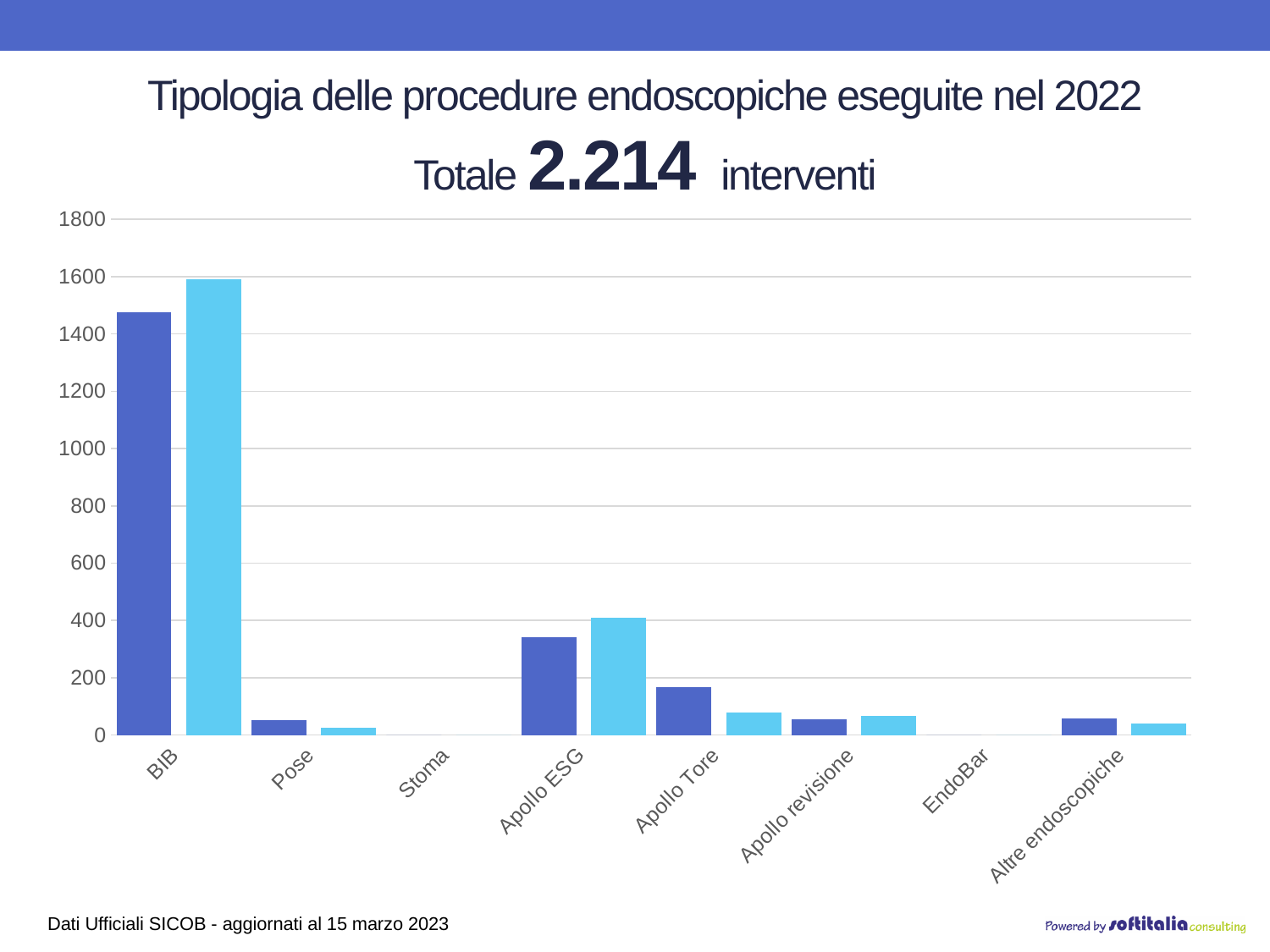
What kind of chart is shown on the slide? bar chart Which category has the highest bars in the chart? BIB Is the value of the dark blue bar for BIB greater or less than 1400? greater Is the value of the dark blue bar for Apollo ESG greater or less than 200? greater Is the value of the dark blue bar for Apollo Tore greater or less than 200? less Which category has larger bars, BIB or Apollo ESG? BIB What total number of interventions is stated in the chart title? 2.214 Which category has a taller dark blue bar, Pose or Apollo Tore? Apollo Tore How many categories are shown on the x axis of the chart? 8 Which category has larger bars, Apollo ESG or Apollo Tore? Apollo ESG